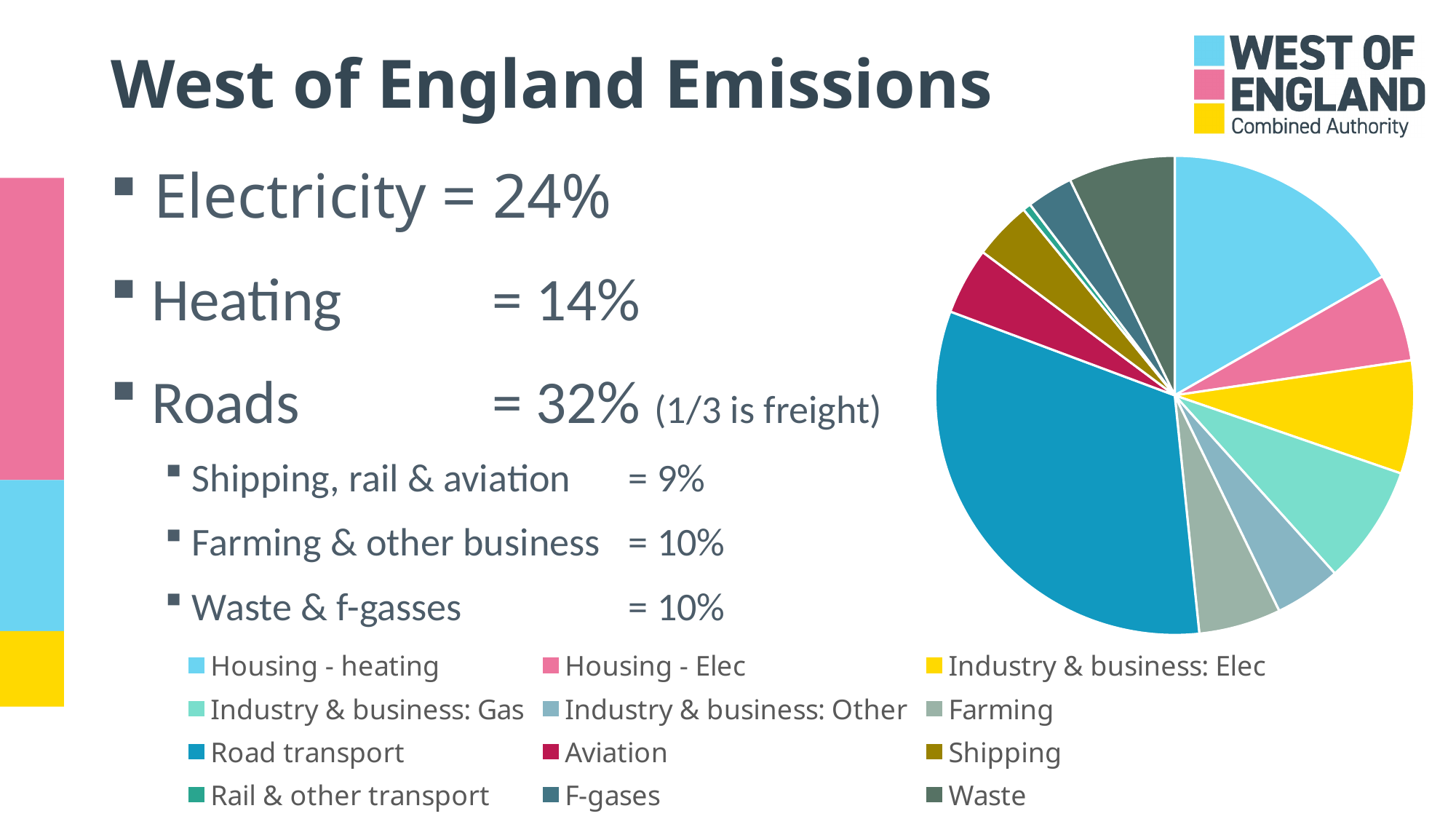
Which slice is larger in the pie chart: Housing - Elec or Rail & other transport? Housing - Elec Which slice is larger in the pie chart: Housing - heating or Housing - Elec? Housing - heating Which category has the largest slice of the pie chart? Road transport Which slice is larger in the pie chart: Road transport or Housing - heating? Road transport Which category has the smallest slice of the pie chart? Rail & other transport What colour is the Road transport slice in the pie chart? blue What is the title of the slide containing the pie chart? West of England Emissions What kind of chart is shown on the slide? pie chart How many categories does the pie chart's legend list? 12